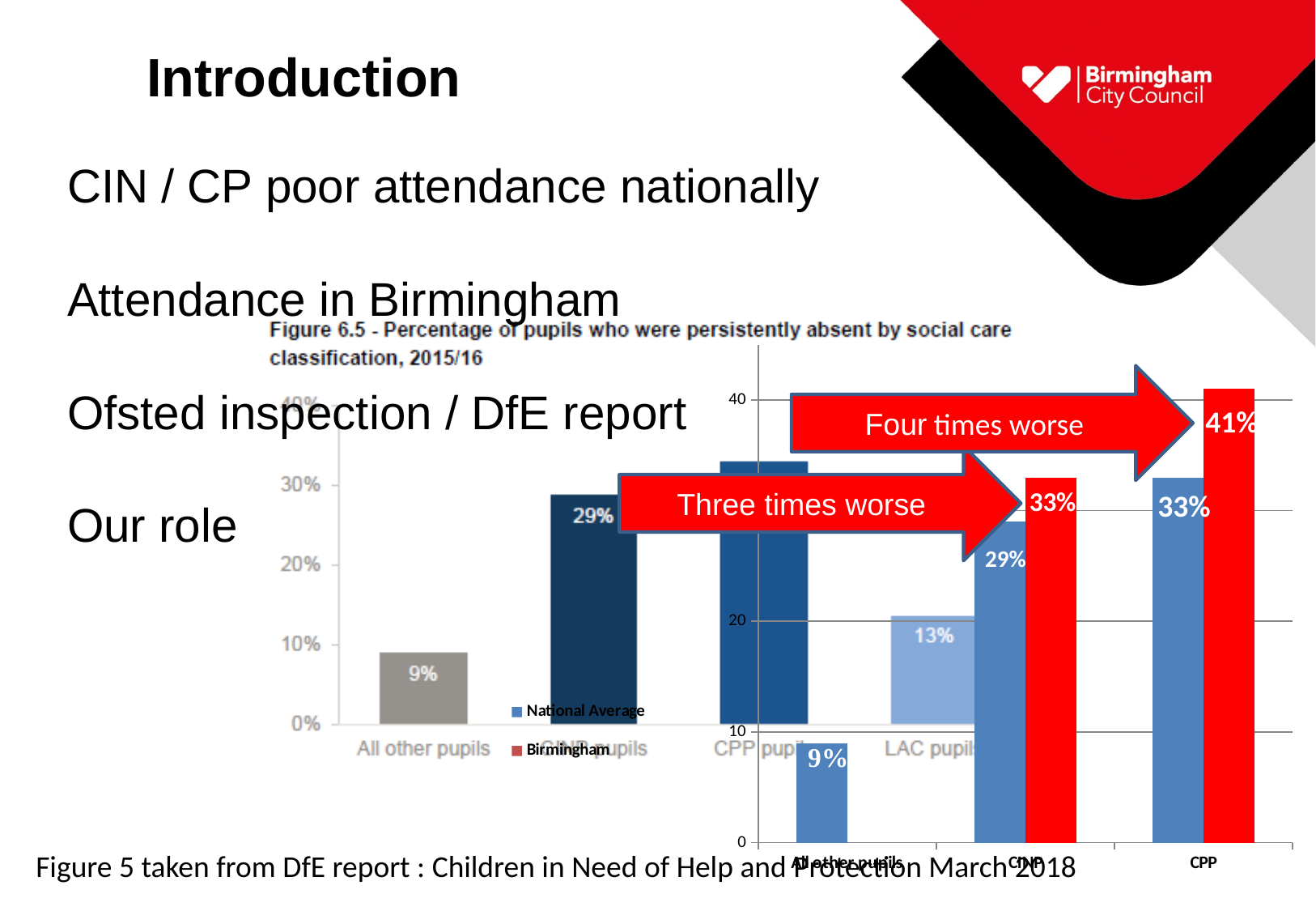
In the chart on the right with the National Average and Birmingham legend, what is the Birmingham value for CPP? 41% In the Figure 6.5 chart, what is the difference between the CIN pupils value and the All other pupils value? 20% In the Figure 6.5 chart, what is the value for CIN pupils? 29% In the Figure 6.5 chart, which category has the highest bar? CPP pupils In the chart on the right with the National Average and Birmingham legend, what is the National Average value for CPP? 33% In the chart on the right, what is the difference between the Birmingham and National Average values for CPP? 8% In the chart on the right, how many series does the legend list? 2 In the chart on the right with the National Average and Birmingham legend, what is the Birmingham value for CIN? 33% In the Figure 6.5 chart, is the value for CPP pupils greater or less than 30%? greater In the Figure 6.5 chart, which category has the lowest percentage of persistently absent pupils? All other pupils In the Figure 6.5 chart, what is the value for LAC pupils? 13% In the Figure 6.5 chart, what percentage of 'All other pupils' were persistently absent? 9%